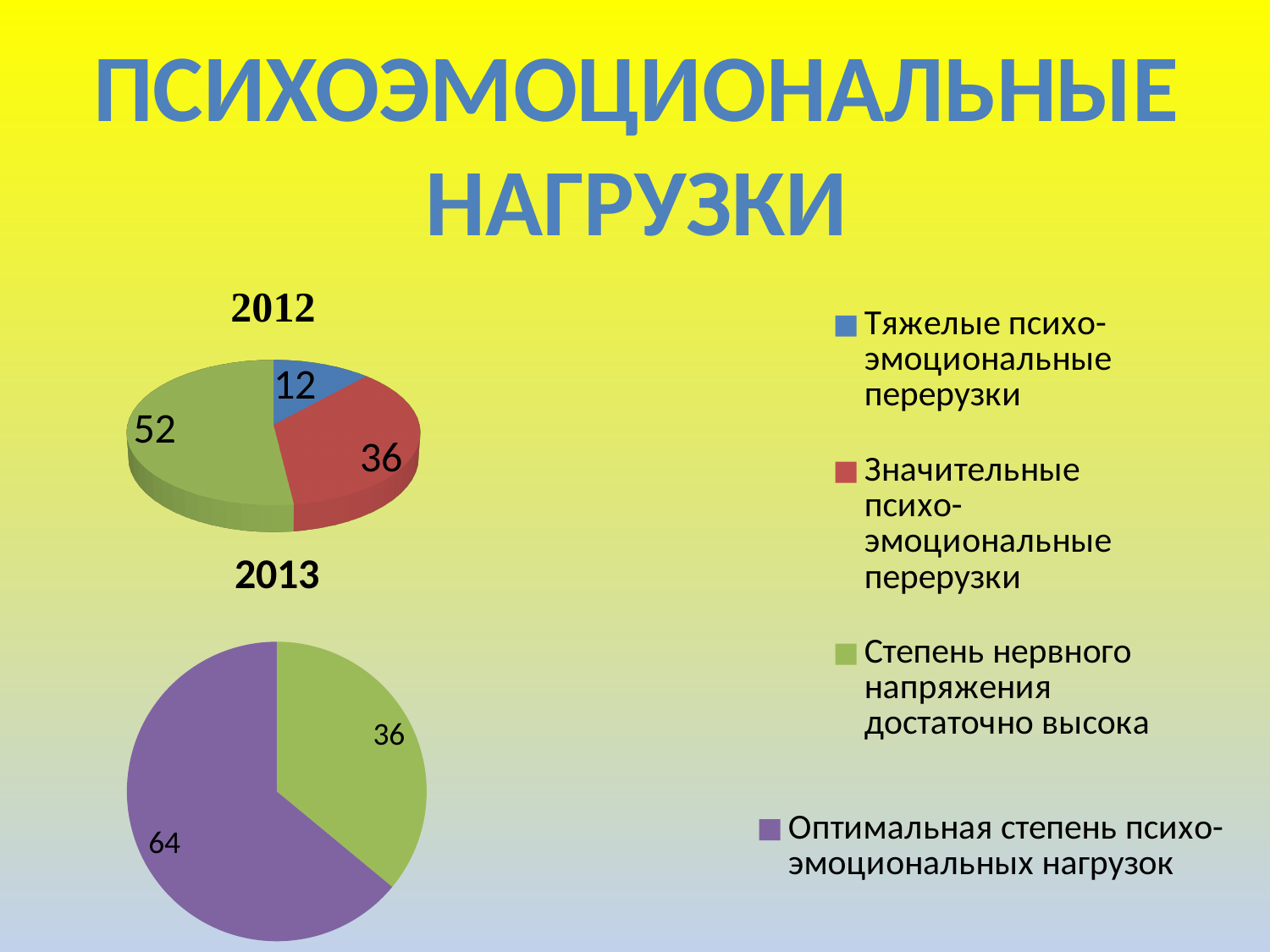
In the "2013" chart, what is the value for "Оптимальная степень психо-эмоциональных нагрузок"? 64 How many entries does the legend on the slide list in total? 4 In the "2012" chart, which category has the smallest slice? Тяжелые психо-эмоциональные перерузки In the "2012" chart, what is the value for "Значительные психо-эмоциональные перерузки"? 36 In the "2012" chart, what is the value for "Тяжелые психо-эмоциональные перерузки"? 12 In the "2012" chart, what is the value for "Степень нервного напряжения достаточно высока"? 52 In the "2012" chart, what is the difference between the values for "Степень нервного напряжения достаточно высока" and "Тяжелые психо-эмоциональные перерузки"? 40 In the "2013" chart, which is larger: the purple slice or the green slice? the purple slice In the "2013" chart, what is the difference between the two slice values? 28 How many slices does the "2012" pie chart have? 3 In the "2012" chart, which category has the largest slice? Степень нервного напряжения достаточно высока What type of chart is the "2012" chart? pie chart